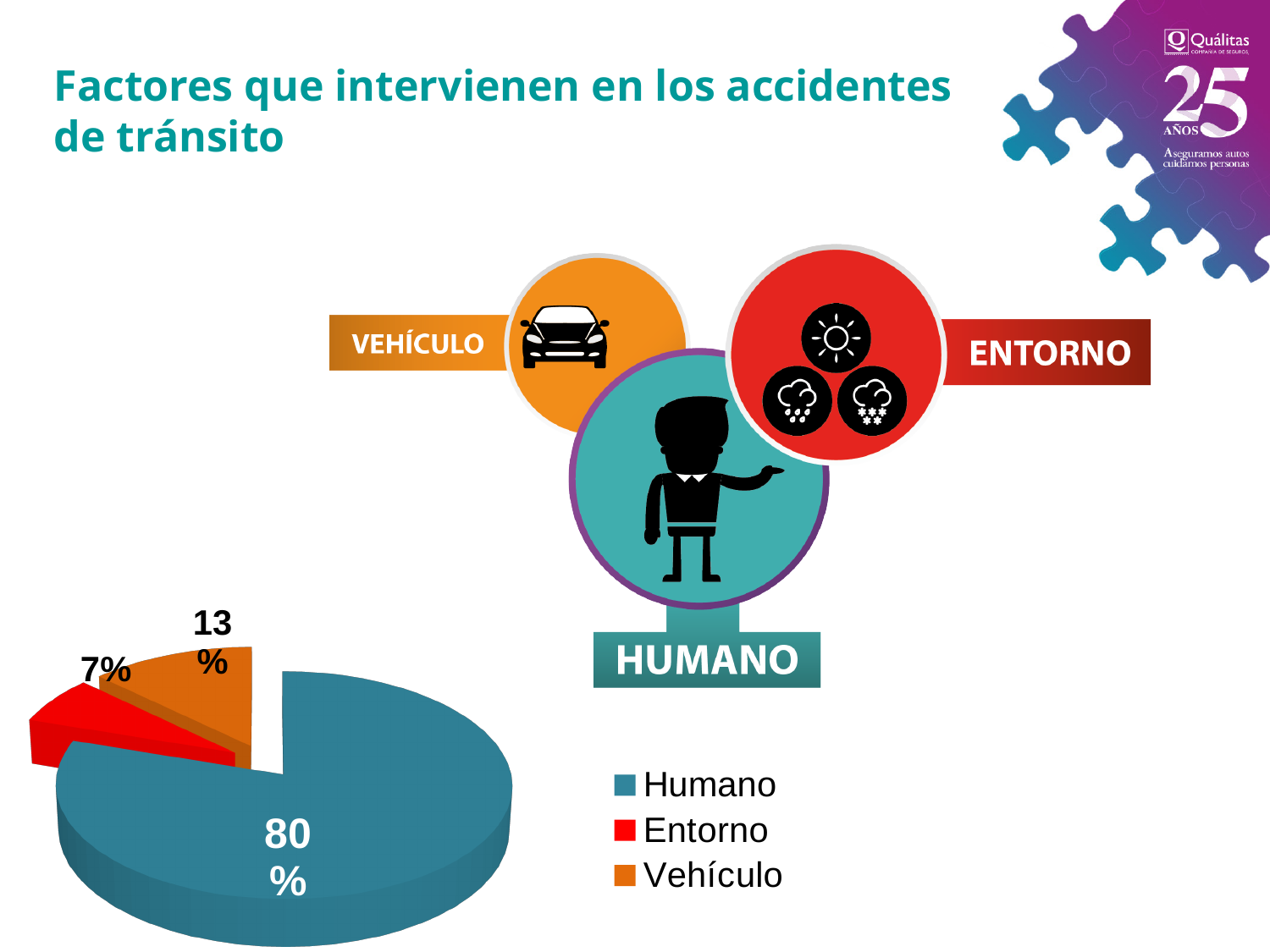
Which category has the smallest slice in the pie chart? Entorno What kind of chart is shown on the slide? pie chart How many entries does the legend of the pie chart list? 3 What percentage of the pie chart is attributed to Entorno? 7% What percentage of the pie chart is attributed to Humano? 80% What is the difference in percentage points between the Vehículo slice and the Entorno slice? 6 Which category has the largest slice in the pie chart? Humano What percentage of the pie chart is attributed to Vehículo? 13% What colour is the Entorno slice in the pie chart? red How many slices does the pie chart have? 3 Which slice is larger, Entorno or Vehículo? Vehículo What is the difference in percentage points between the Humano slice and the Vehículo slice? 67